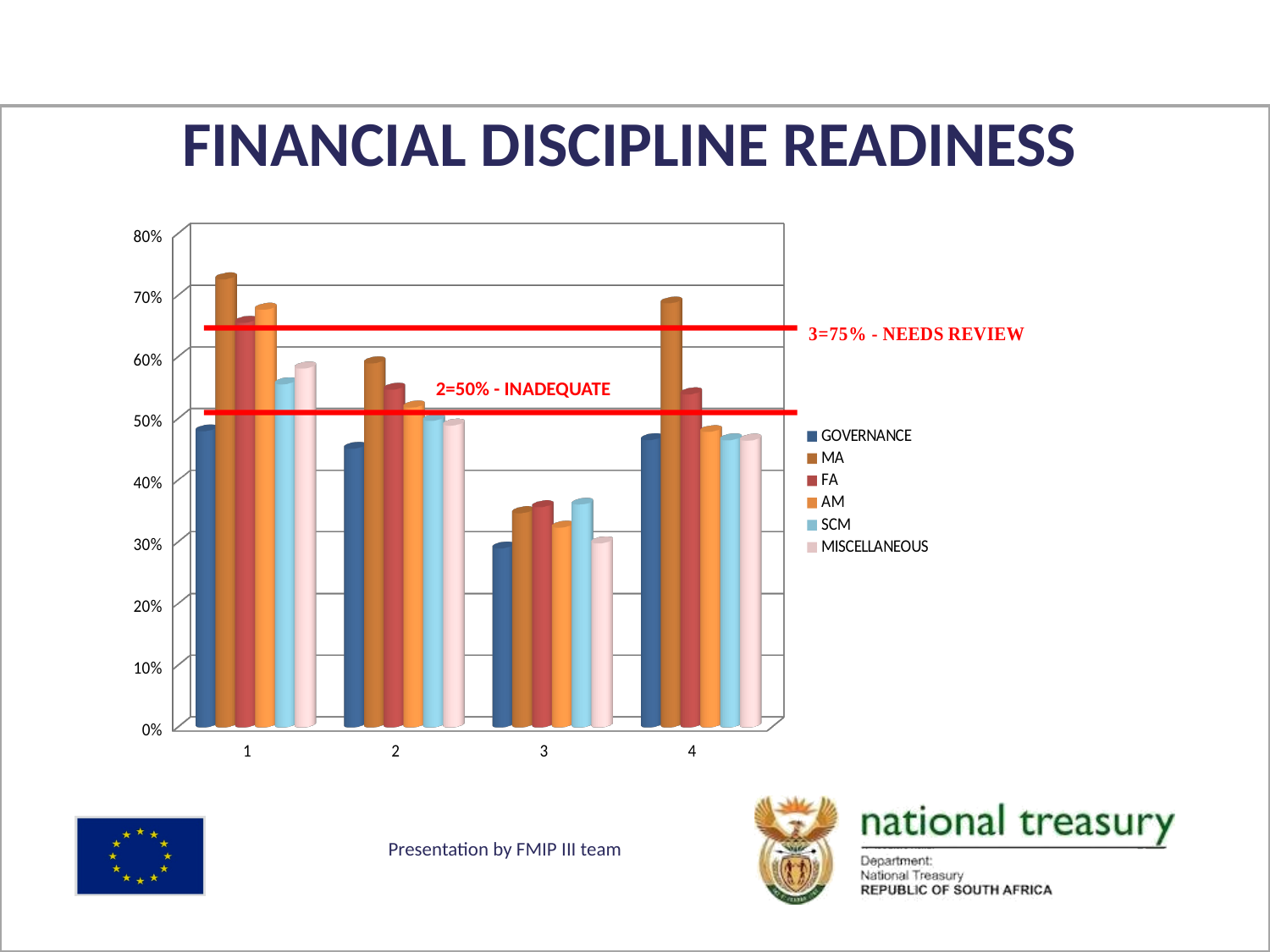
Is the GOVERNANCE value for category 3 greater or less than 40%? less How many series does the chart legend list? 6 Which series has the highest value in category 1? MA What kind of chart is shown on the slide? bar chart In which category is the GOVERNANCE value lowest? 3 Is the MA value for category 4 greater or less than 60%? greater Which is larger: the MA value for category 2 or the MA value for category 3? category 2 How many categories are shown on the x axis of the chart? 4 In category 4, which is larger: the MA value or the GOVERNANCE value? MA Is the MA value for category 1 greater or less than 70%? greater What label is attached to the upper red horizontal line on the chart? 3=75% - NEEDS REVIEW What is the title of the slide containing the chart? FINANCIAL DISCIPLINE READINESS